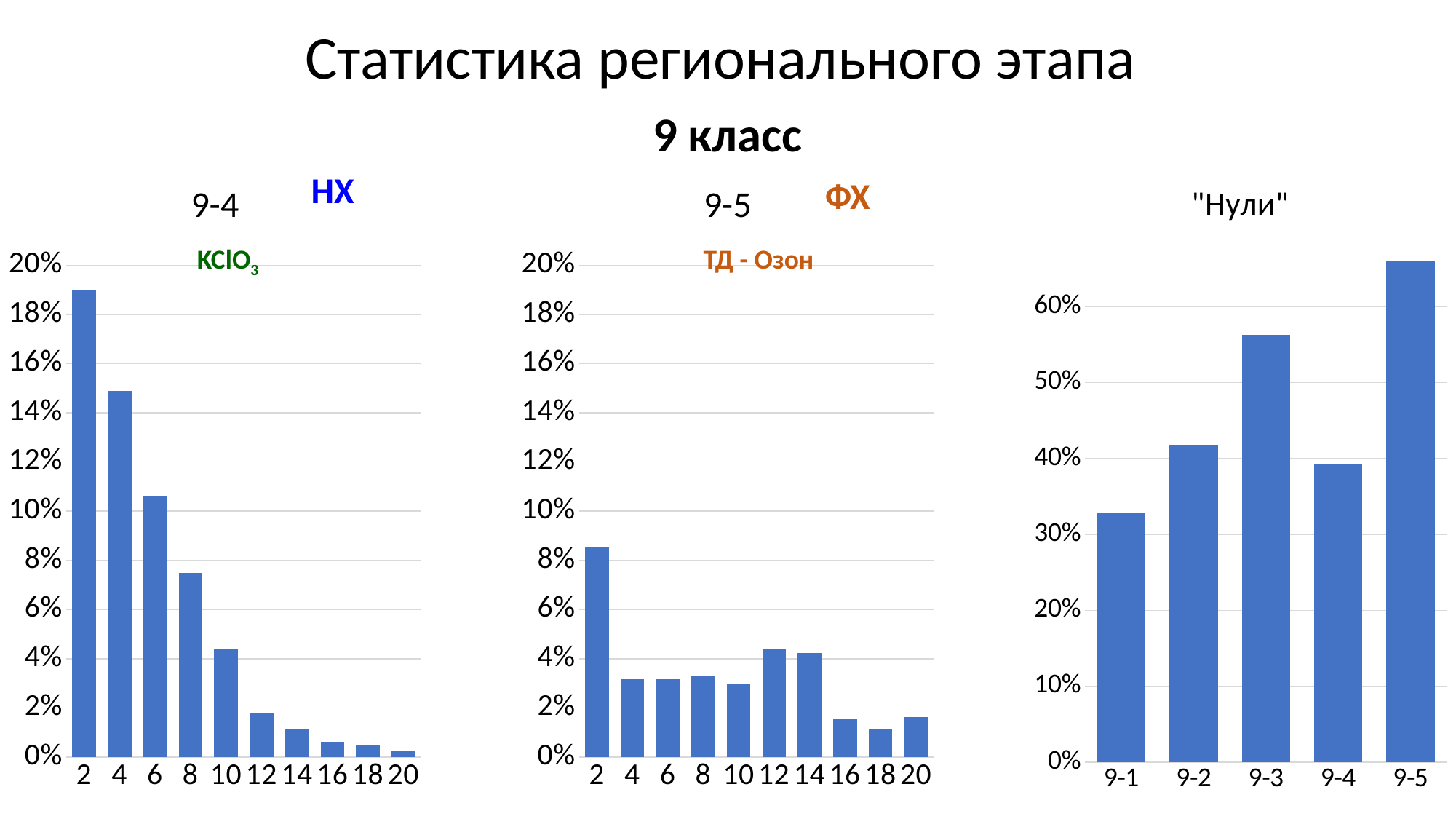
In the "9-4" chart, do the values rise or fall as you move from 2 to 20 along the x axis? fall In the "9-4" chart, which category has the highest value? 2 In the "9-4" chart, is the value for category 8 greater or less than 8%? less In the "9-5" chart, which category has the highest value? 2 How many bars are plotted in the "9-4" chart? 10 In the "Нули" chart, which category has the lowest value? 9-1 In the "9-4" chart, is the value for category 2 greater or less than 18%? greater In the "9-5" chart, which category has the lowest value? 18 In the "9-5" chart, which is larger, the value for category 12 or the value for category 10? 12 In the "Нули" chart, which category has the highest value? 9-5 In the "Нули" chart, is the value for 9-3 greater or less than 50%? greater